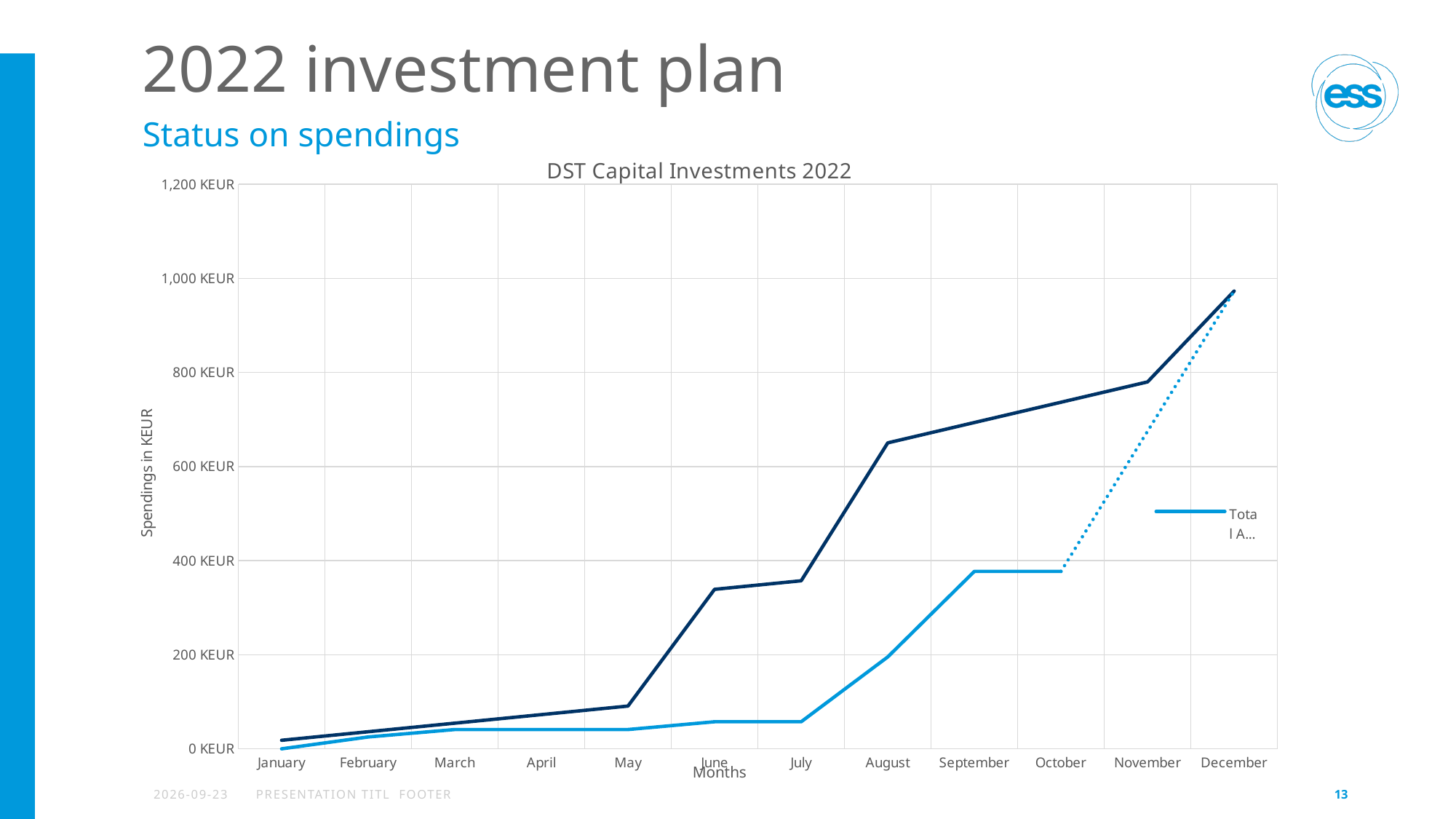
Does the dark blue line rise or fall from January to December? rise Is the value of the dark blue line in May greater or less than 200 KEUR? less What is the label of the vertical axis? Spendings in KEUR What is the title of the chart? DST Capital Investments 2022 Is the value of the dark blue line in December greater or less than 800 KEUR? greater Is the value of the light blue line in July greater or less than 200 KEUR? less In which month does the dark blue line reach its highest value? December In August, which line has the higher value, the dark blue line or the light blue line? dark blue line How many months are shown along the x axis? 12 What kind of chart is shown on the slide? line chart